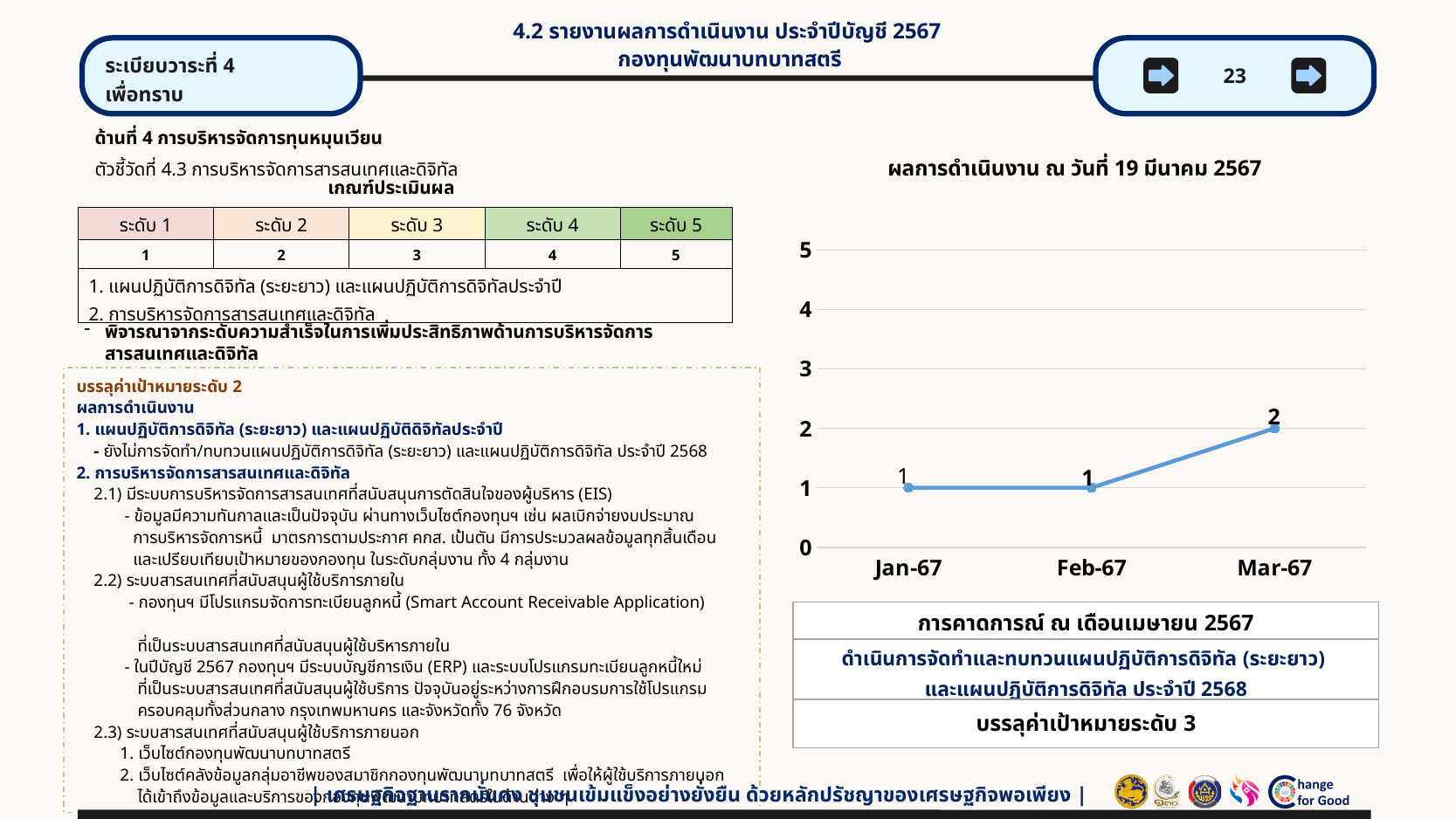
What is the difference between the values for Mar-67 and Feb-67? 1 How many data points are plotted on the chart? 3 What is the value for Jan-67? 1 Which is larger, the value for Mar-67 or the value for Jan-67? Mar-67 What is the value for Feb-67? 1 What is the value for Mar-67? 2 What is the highest value shown on the y axis? 5 Is the value for Mar-67 greater or less than 3? less Do the values rise or fall from Feb-67 to Mar-67? rise What type of chart is shown on the slide? line chart Which month has the highest value? Mar-67 What is the title of the chart? ผลการดำเนินงาน ณ วันที่ 19 มีนาคม 2567